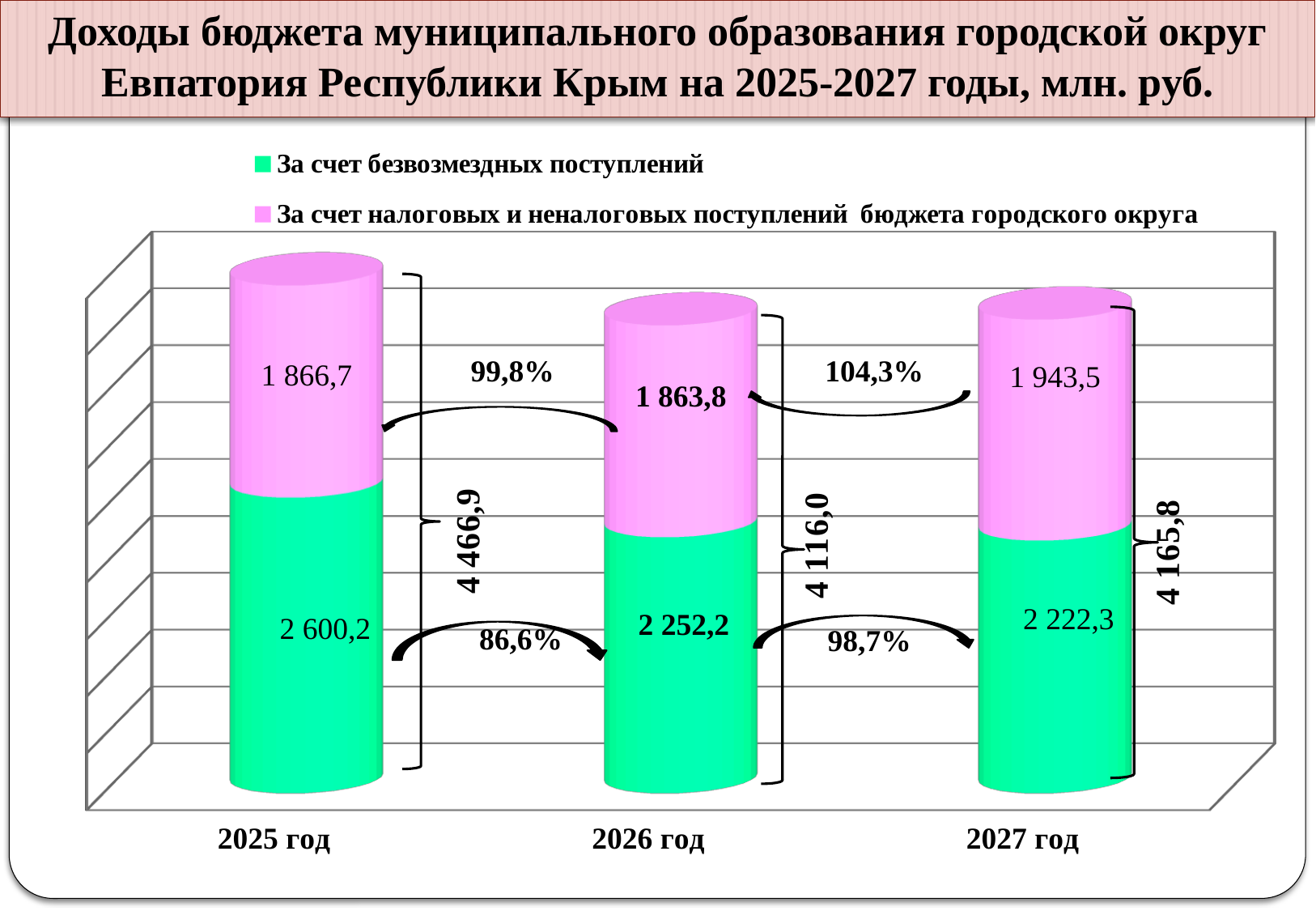
How many years are shown on the x axis of the chart? 3 What is the difference between the 'За счет безвозмездных поступлений' values for 2025 год and 2026 год? 348,0 What is the value for 'За счет налоговых и неналоговых поступлений бюджета городского округа' in 2026 год? 1 863,8 What kind of chart is shown on the slide? Stacked bar chart What is the value for 'За счет налоговых и неналоговых поступлений бюджета городского округа' in 2027 год? 1 943,5 How many series does the legend list? 2 In which year is the value for 'За счет безвозмездных поступлений' the lowest? 2027 год What is the value for 'За счет безвозмездных поступлений' in 2025 год? 2 600,2 What is the total of the stacked bar for 2026 год? 4 116,0 Which is larger in 2027 год: 'За счет безвозмездных поступлений' or 'За счет налоговых и неналоговых поступлений бюджета городского округа'? За счет безвозмездных поступлений What is the total of the stacked bar for 2027 год? 4 165,8 In which year is the total budget income the highest? 2025 год